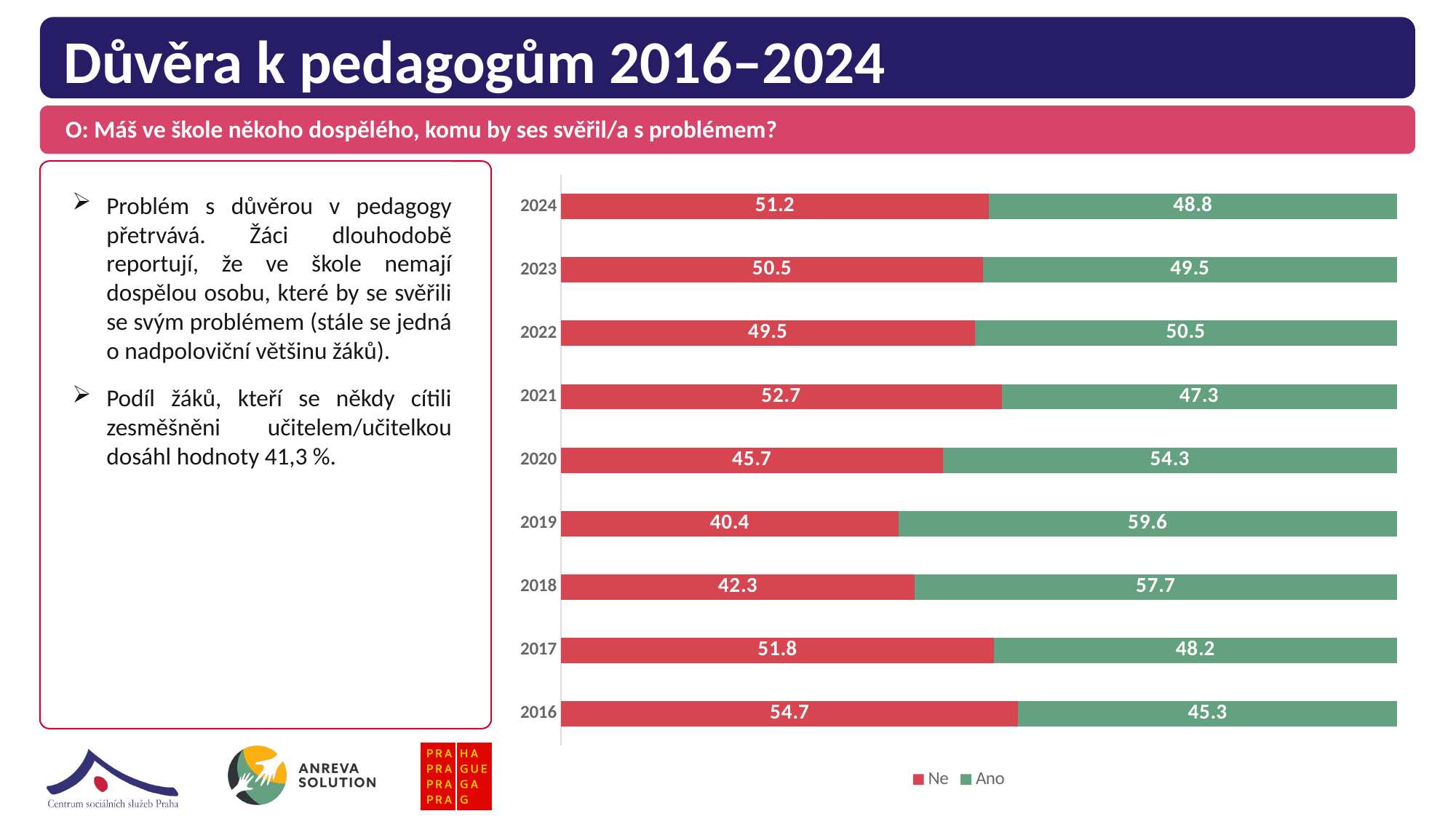
In which year is the "Ne" value the lowest? 2019 What is the total of the stacked bar for 2020? 100 Which is larger: the "Ne" value in 2021 or the "Ne" value in 2020? 2021 What is the value for "Ne" in 2024? 51.2 How many years are shown on the chart? 9 In which year is the "Ano" value the highest? 2019 What is the value for "Ano" in 2019? 59.6 How many series does the legend list? 2 What kind of chart is shown on the slide? Stacked bar chart What is the value for "Ne" in 2016? 54.7 What is the difference between the "Ne" and "Ano" values in 2024? 2.4 In which year is the "Ne" value the highest? 2016